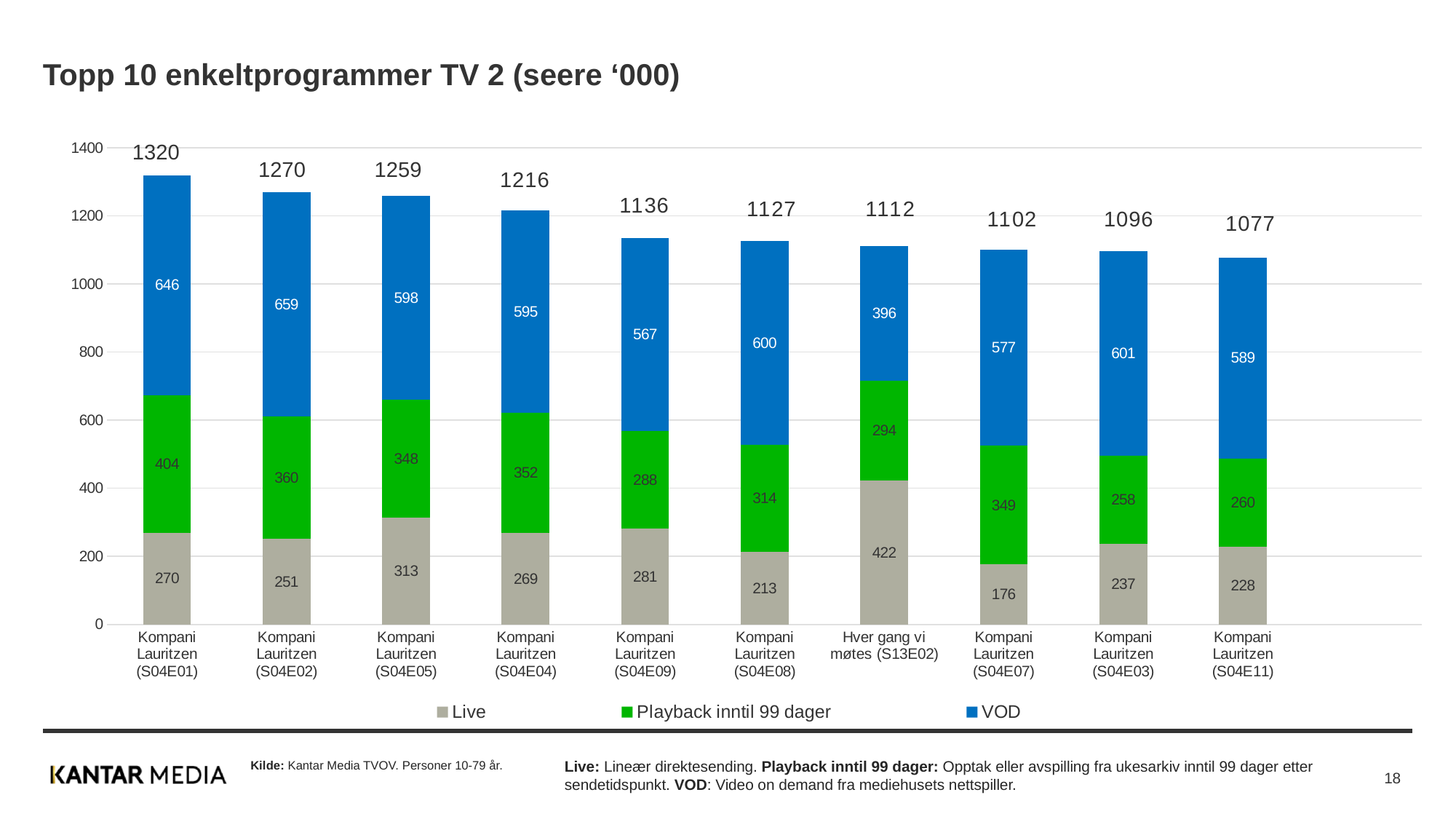
What is the Live value for Kompani Lauritzen (S04E01)? 270 What is the VOD value for Hver gang vi møtes (S13E02)? 396 Which programme has the highest total viewers? Kompani Lauritzen (S04E01) What kind of chart is shown on the slide? Stacked bar chart What is the Playback inntil 99 dager value for Kompani Lauritzen (S04E07)? 349 Which programme has the lowest Live value? Kompani Lauritzen (S04E07) What is the total for the Kompani Lauritzen (S04E09) bar? 1136 How many programmes are shown on the chart? 10 How many series does the legend list? 3 What is the title of the chart? Topp 10 enkeltprogrammer TV 2 (seere ‘000) Which is larger: the VOD value for Kompani Lauritzen (S04E02) or for Kompani Lauritzen (S04E05)? Kompani Lauritzen (S04E02) What is the difference between the total for Kompani Lauritzen (S04E01) and Kompani Lauritzen (S04E11)? 243